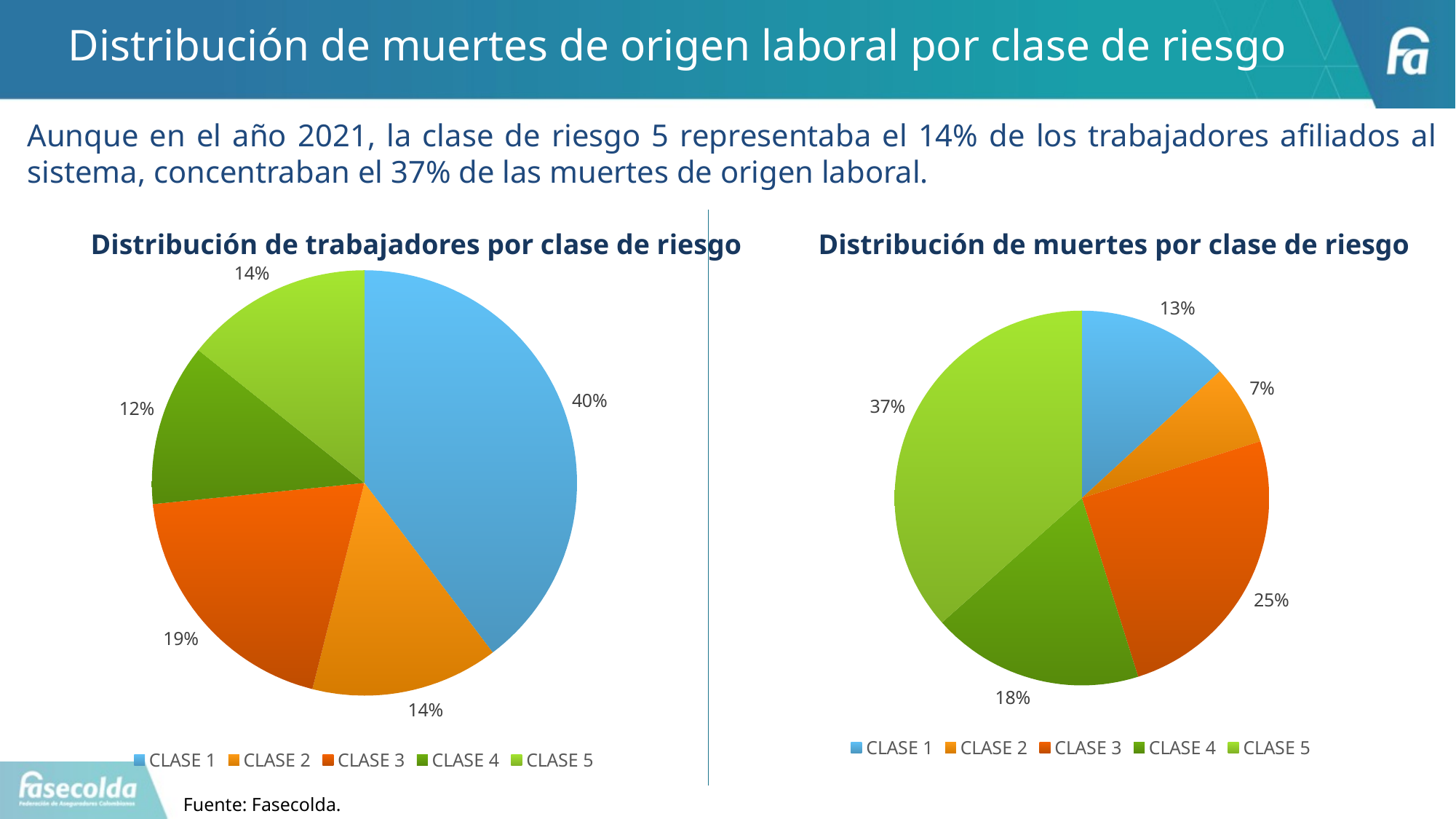
In the chart 'Distribución de trabajadores por clase de riesgo', which is larger, the share of CLASE 3 or the share of CLASE 4? CLASE 3 In the chart 'Distribución de muertes por clase de riesgo', what is the difference between the shares of CLASE 5 and CLASE 1? 24 percentage points In the chart 'Distribución de muertes por clase de riesgo', what share does CLASE 3 have? 25% What type of chart is 'Distribución de muertes por clase de riesgo'? Pie chart How many slices does the chart 'Distribución de muertes por clase de riesgo' have? 5 In the chart 'Distribución de trabajadores por clase de riesgo', which class has the largest share? CLASE 1 How many entries does the legend of the chart 'Distribución de trabajadores por clase de riesgo' list? 5 In the chart 'Distribución de trabajadores por clase de riesgo', which class has the smallest share? CLASE 4 In the chart 'Distribución de muertes por clase de riesgo', what share does CLASE 4 have? 18% In the chart 'Distribución de muertes por clase de riesgo', what share does CLASE 5 have? 37% In the chart 'Distribución de muertes por clase de riesgo', which class has the smallest share? CLASE 2 In the chart 'Distribución de trabajadores por clase de riesgo', what share does CLASE 1 have? 40%